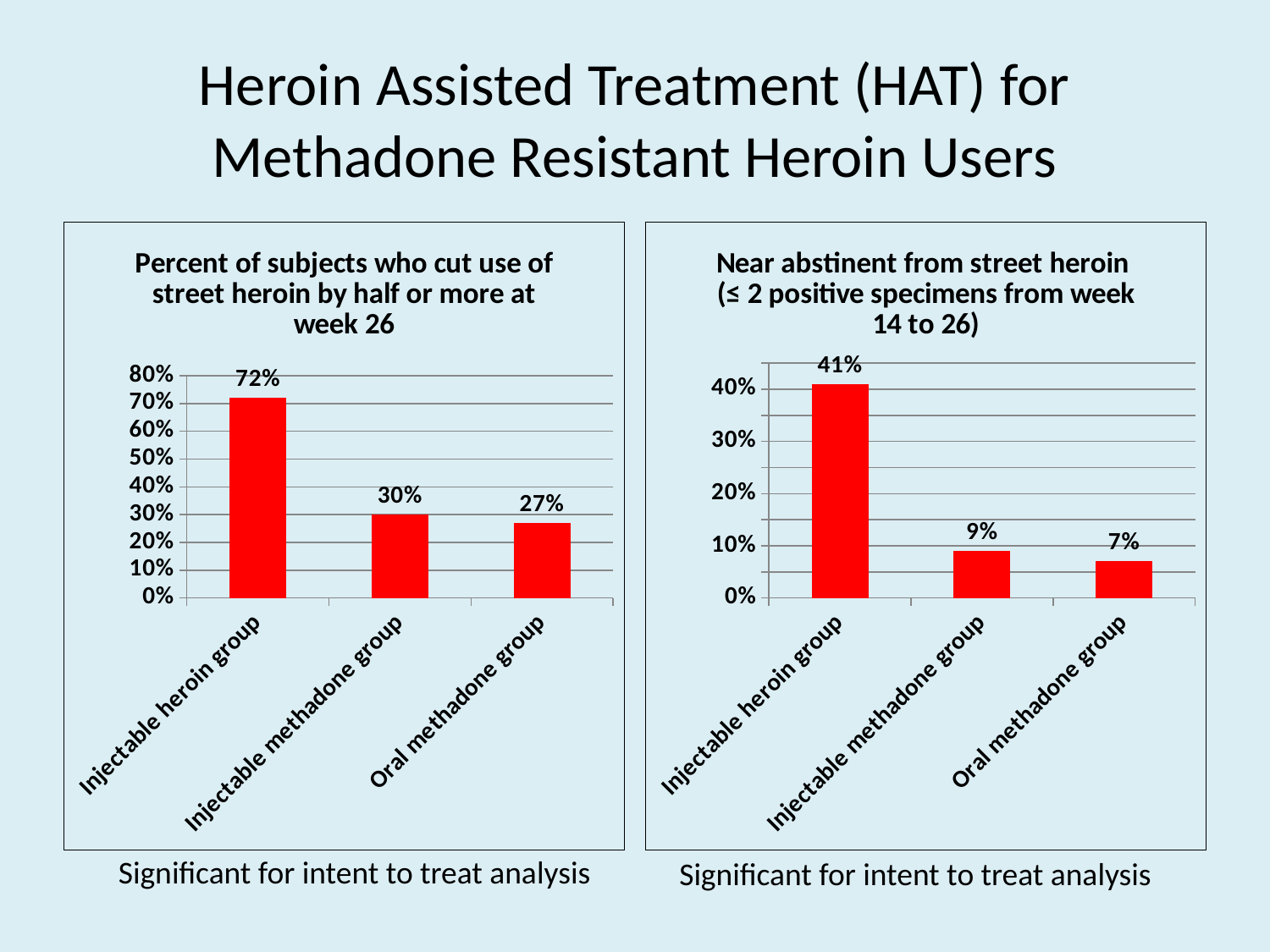
In the left chart (Percent of subjects who cut use of street heroin by half or more at week 26), do the values rise or fall from left to right along the x axis? Fall In the right chart (Near abstinent from street heroin), which group has the lowest value? Oral methadone group How many groups are shown on the x axis of the left chart (Percent of subjects who cut use of street heroin by half or more at week 26)? 3 In the left chart (Percent of subjects who cut use of street heroin by half or more at week 26), what is the difference between the Injectable heroin group and the Injectable methadone group? 42% What kind of chart is the right chart (Near abstinent from street heroin)? Bar chart In the left chart (Percent of subjects who cut use of street heroin by half or more at week 26), what is the value for the Injectable heroin group? 72% In the left chart (Percent of subjects who cut use of street heroin by half or more at week 26), what is the value for the Oral methadone group? 27% In the right chart (Near abstinent from street heroin), which is larger: the Injectable methadone group or the Oral methadone group? Injectable methadone group In the left chart (Percent of subjects who cut use of street heroin by half or more at week 26), which group has the highest value? Injectable heroin group In the right chart (Near abstinent from street heroin), what is the value for the Injectable methadone group? 9% In the right chart (Near abstinent from street heroin), what is the difference between the Injectable heroin group and the Oral methadone group? 34% In the right chart (Near abstinent from street heroin), what is the value for the Injectable heroin group? 41%